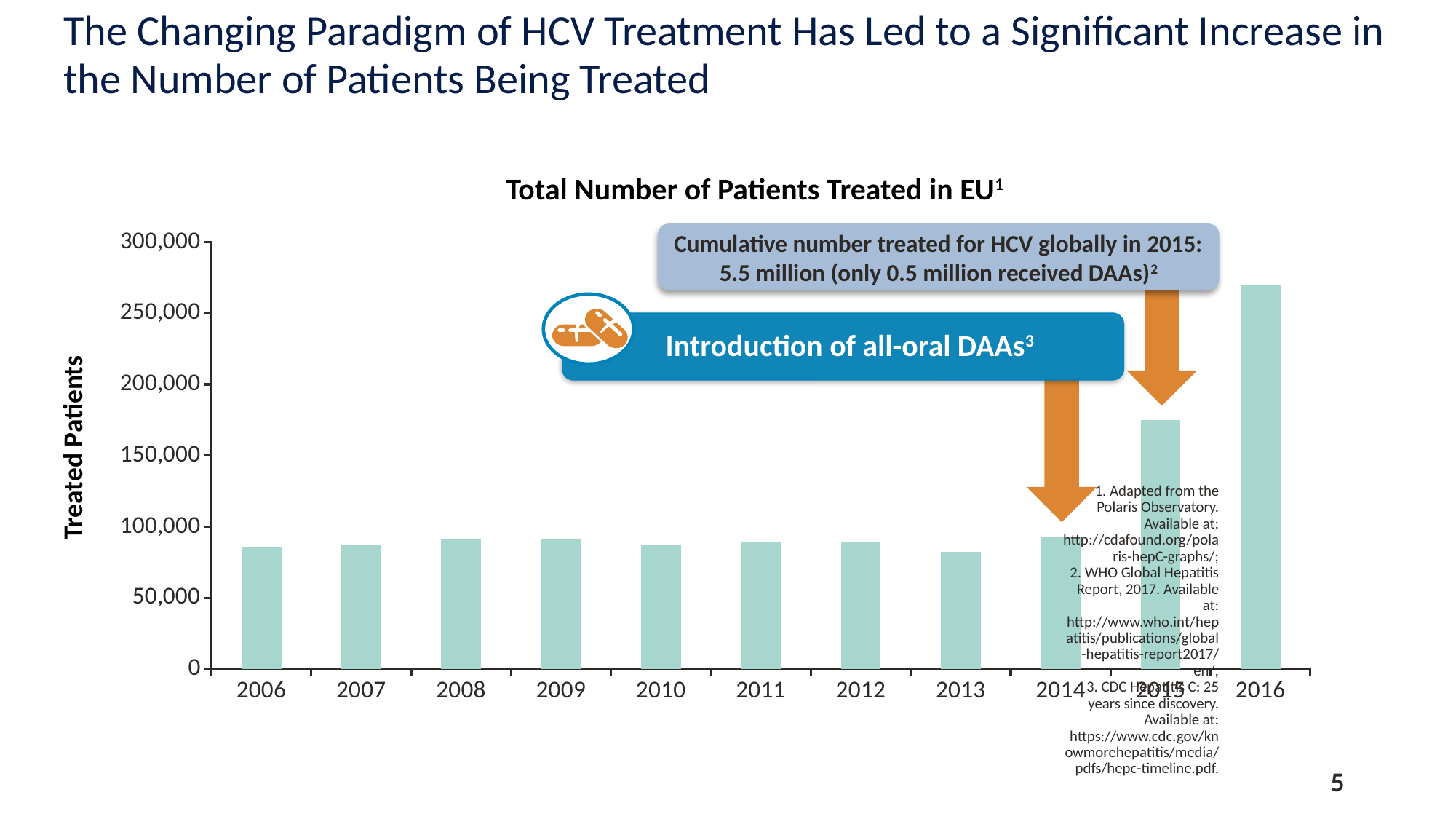
Which year has more treated patients, 2014 or 2015? 2015 What type of chart is shown on the slide? Bar chart Is the value for 2015 greater or less than 150,000? greater What is the title of the chart? Total Number of Patients Treated in EU Which year has more treated patients, 2015 or 2016? 2016 Is the value for 2014 greater or less than 100,000? less What is the label on the vertical axis of the chart? Treated Patients Is the value for 2006 greater or less than 100,000? less How many years are shown on the x axis of the chart? 11 Which year has the highest number of treated patients? 2016